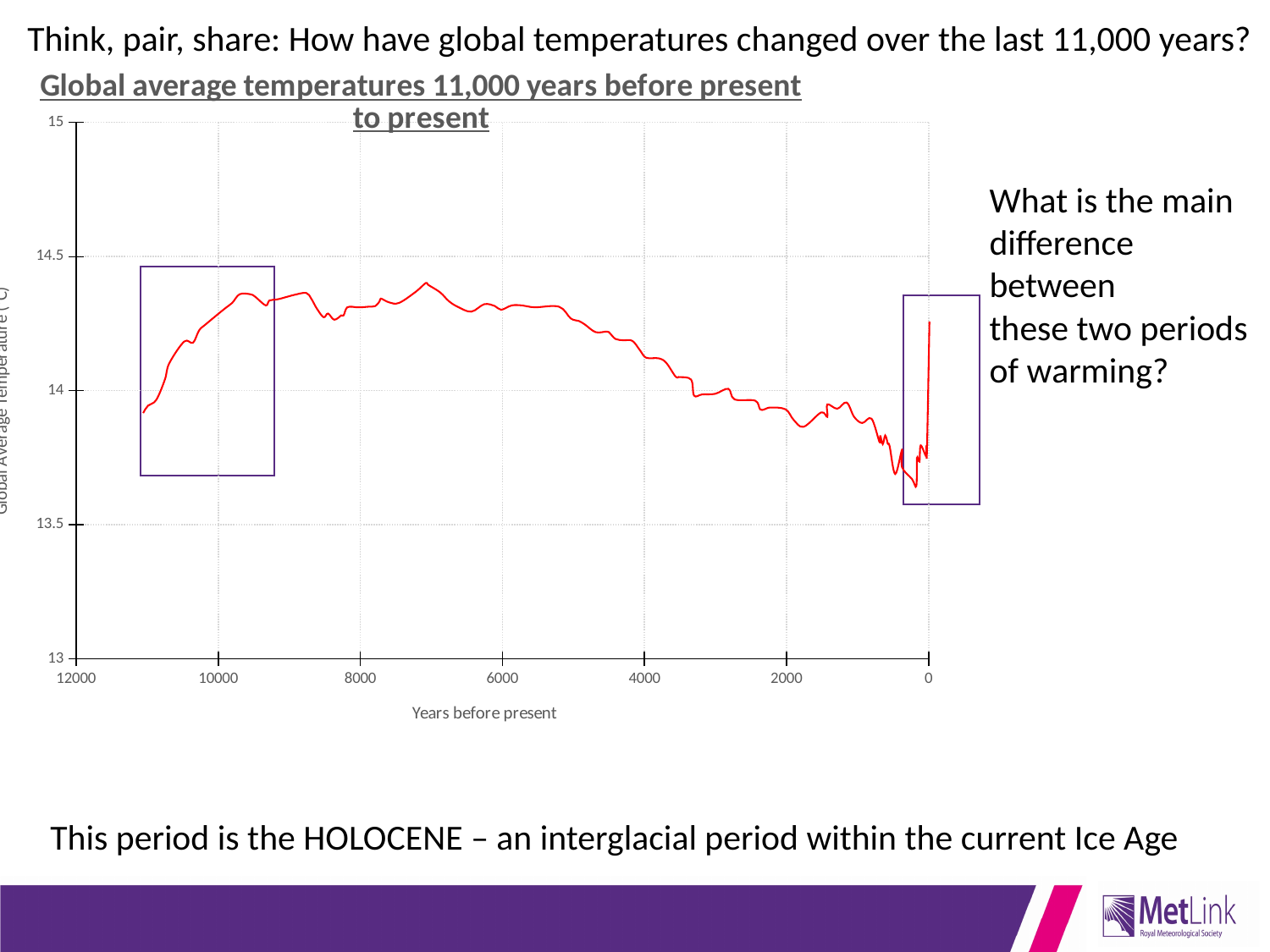
Is the temperature at 6000 years before present greater or less than 14? greater Does the temperature rise or fall between 11000 and 9500 years before present? rise Is the temperature at 7000 years before present greater or less than 14.5? less How many data series are plotted on the chart? 1 Which is higher, the temperature at 8000 years before present or at 2000 years before present? 8000 years before present What is the title of the chart? Global average temperatures 11,000 years before present to present What kind of chart is shown on the slide? line chart Does the temperature rise or fall between 6000 and 2000 years before present? fall Is the temperature at 500 years before present greater or less than 13.5? greater What is the label of the x axis of the chart? Years before present